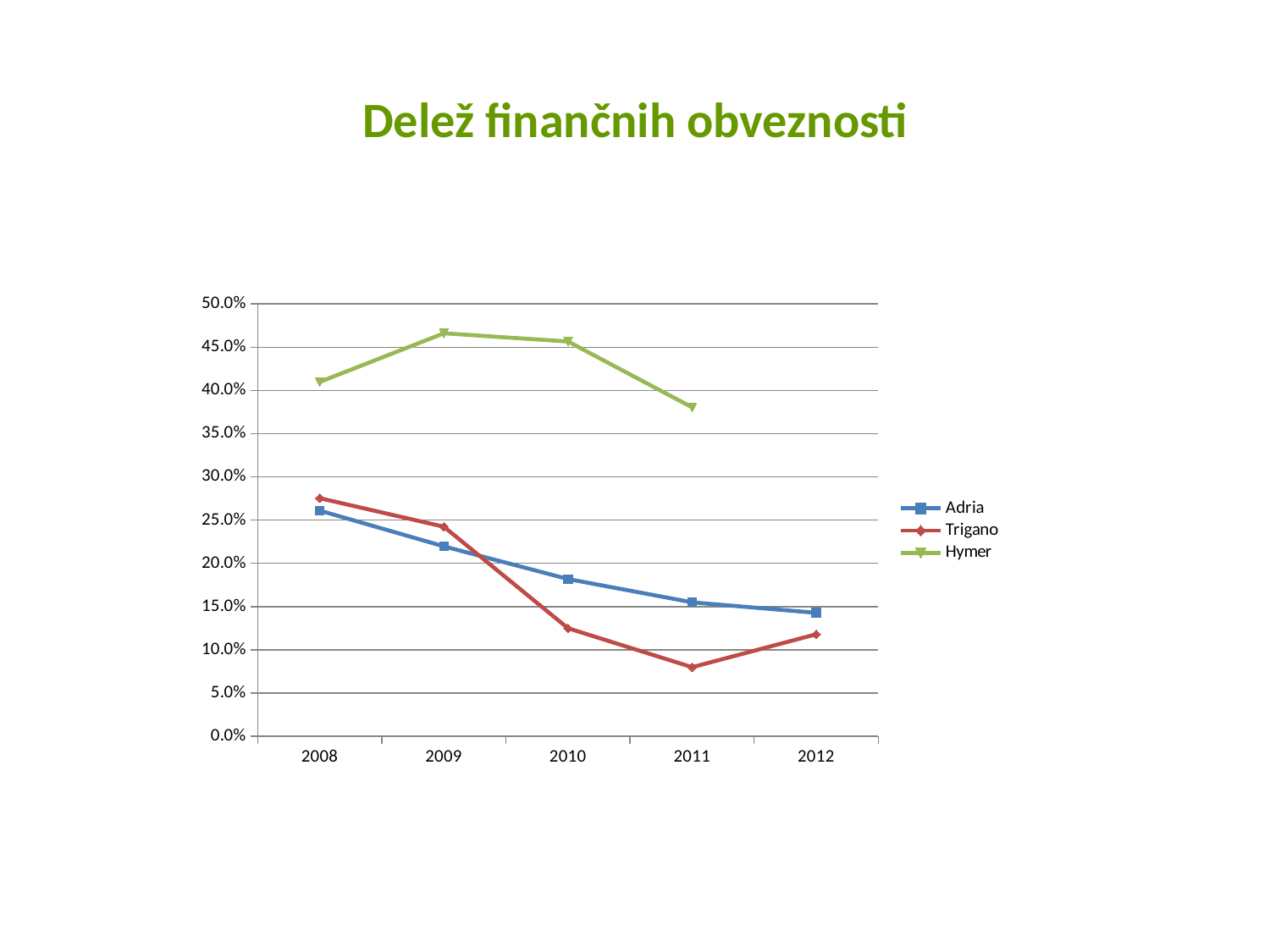
Which series is lowest in 2011? Trigano Does the Adria series rise or fall from 2008 to 2012? fall What kind of chart is shown on the slide? line chart In which year is the Trigano value lowest? 2011 Is the value for Trigano in 2011 greater or less than 10.0%? less Is the value for Hymer in 2011 greater or less than 40.0%? less How many years are shown on the x axis? 5 Is the value for Hymer in 2009 greater or less than 45.0%? greater Which is larger in 2011, the value for Adria or the value for Trigano? Adria Which series is highest in 2009? Hymer What is the title of the chart? Delež finančnih obveznosti How many series does the legend list? 3